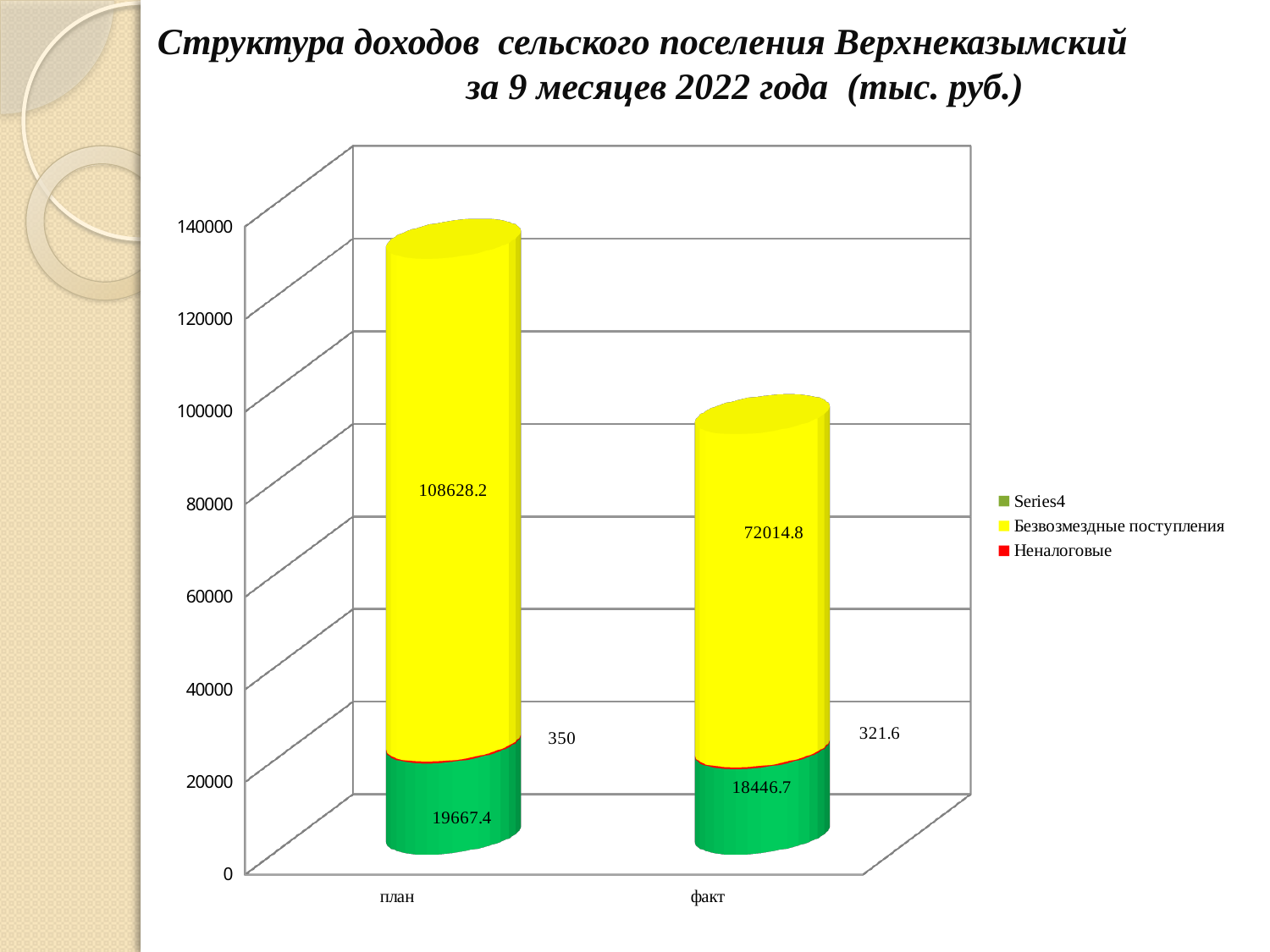
How many categories are shown on the x axis? 2 What is the difference between the Безвозмездные поступления values for план and факт? 36613.4 What is the value of Безвозмездные поступления for факт? 72014.8 What is the total of the stacked bar for план? 128645.6 What is the total of the stacked bar for факт? 90783.1 What is the value of Безвозмездные поступления for план? 108628.2 What is the value of Неналоговые for план? 350 How many series does the legend list? 3 Which category has the larger Неналоговые value, план or факт? план What kind of chart is shown on the slide? Stacked bar chart